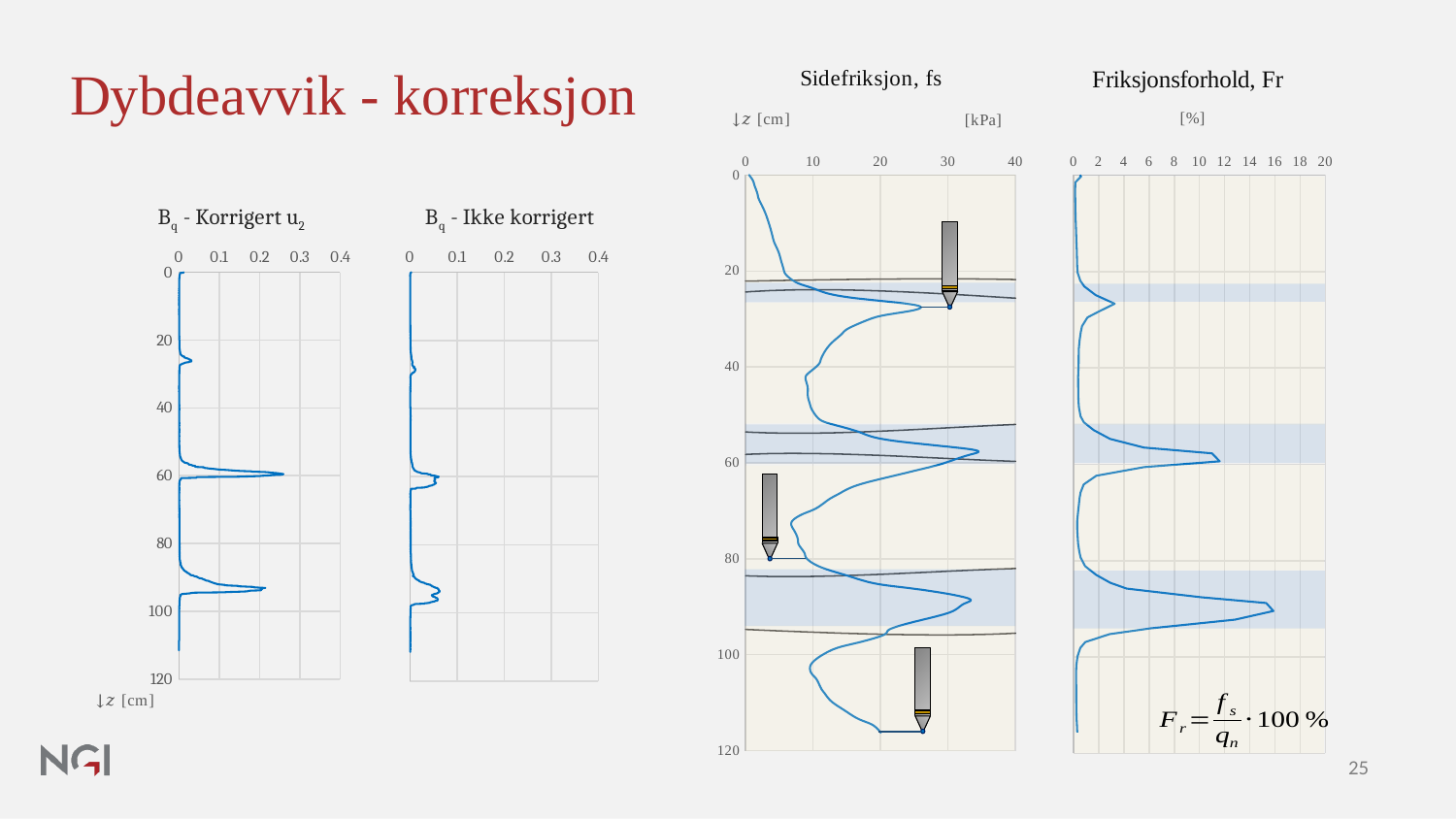
In the 'Sidefriksjon, fs' chart, is the value at 0 cm depth greater or less than 10 kPa? less What unit is shown on the x axis of the 'Friksjonsforhold, Fr' chart? [%] How many charts are shown on the slide? 4 In the 'Friksjonsforhold, Fr' chart, is the peak value near 90 cm depth greater or less than 10%? greater In the 'Friksjonsforhold, Fr' chart, is the peak value near 25 cm depth greater or less than 6%? less What kind of chart is the 'Sidefriksjon, fs' chart? line chart In the 'Sidefriksjon, fs' chart, is the peak near 58 cm depth larger or smaller than the value at 40 cm depth? larger Is the peak near 60 cm depth larger in the 'Bq - Korrigert u2' chart or in the 'Bq - Ikke korrigert' chart? Bq - Korrigert u2 In the 'Friksjonsforhold, Fr' chart, is the peak near 90 cm depth larger or smaller than the peak near 60 cm depth? larger